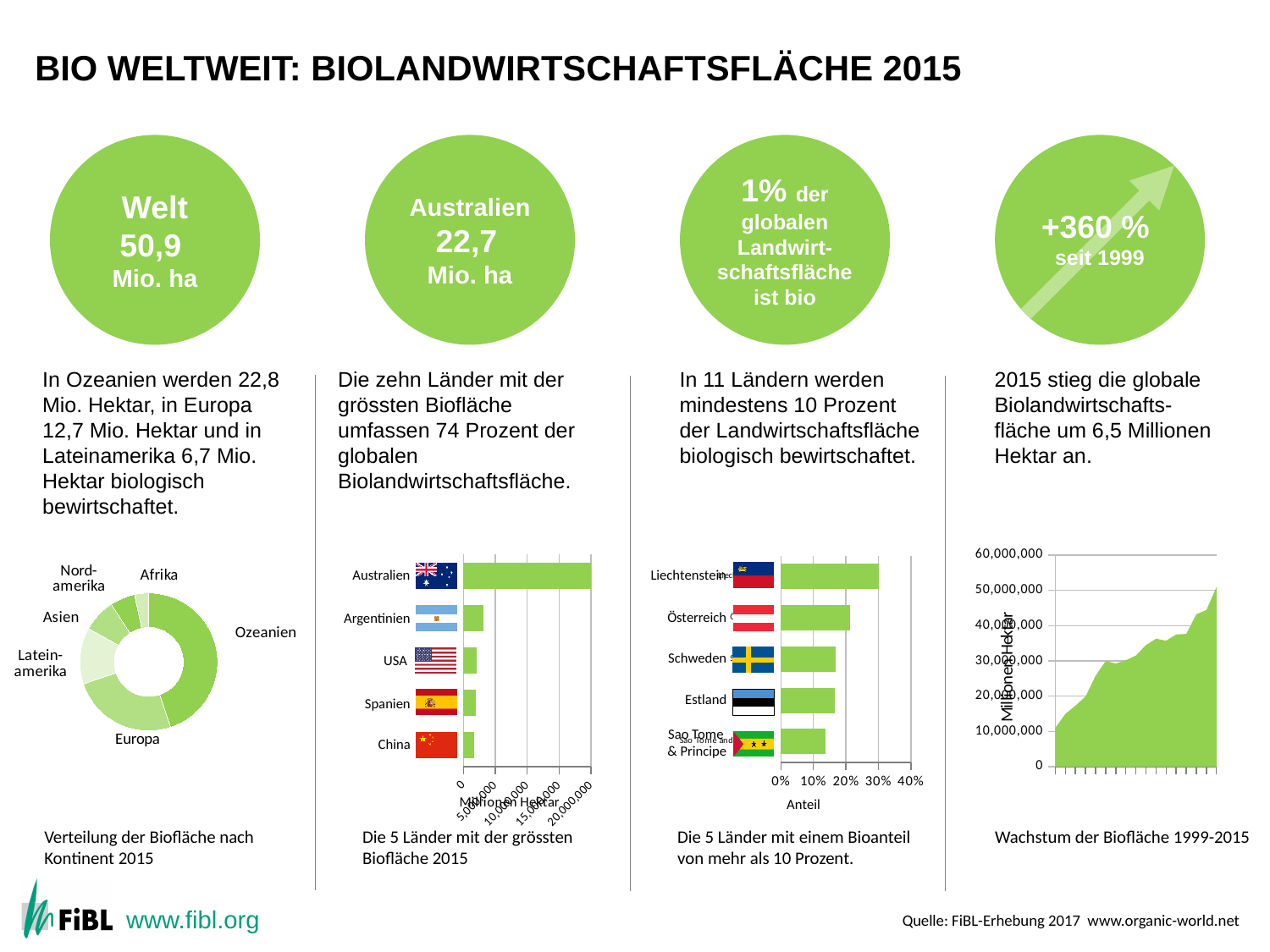
In the 'Die 5 Länder mit der grössten Biofläche 2015' chart, is the value for Australien greater or less than 20,000,000? greater In the 'Die 5 Länder mit der grössten Biofläche 2015' chart, which country has the highest value? Australien In the 'Die 5 Länder mit der grössten Biofläche 2015' chart, which is larger, the value for Argentinien or the value for China? Argentinien In the 'Die 5 Länder mit einem Bioanteil von mehr als 10 Prozent' chart, which country has the highest share? Liechtenstein In the 'Die 5 Länder mit einem Bioanteil von mehr als 10 Prozent' chart, what is the x-axis title? Anteil In the 'Die 5 Länder mit einem Bioanteil von mehr als 10 Prozent' chart, is the value for Schweden greater or less than 20%? less What kind of chart is 'Die 5 Länder mit der grössten Biofläche 2015'? Bar chart What kind of chart is the 'Verteilung der Biofläche nach Kontinent 2015' chart? Pie (donut) chart In the 'Verteilung der Biofläche nach Kontinent 2015' chart, how many continents are shown? 6 In the 'Verteilung der Biofläche nach Kontinent 2015' chart, which continent has the largest slice? Ozeanien In the 'Wachstum der Biofläche 1999-2015' chart, do the values rise or fall over time? Rise In the 'Die 5 Länder mit der grössten Biofläche 2015' chart, is the value for Argentinien greater or less than 5,000,000? less